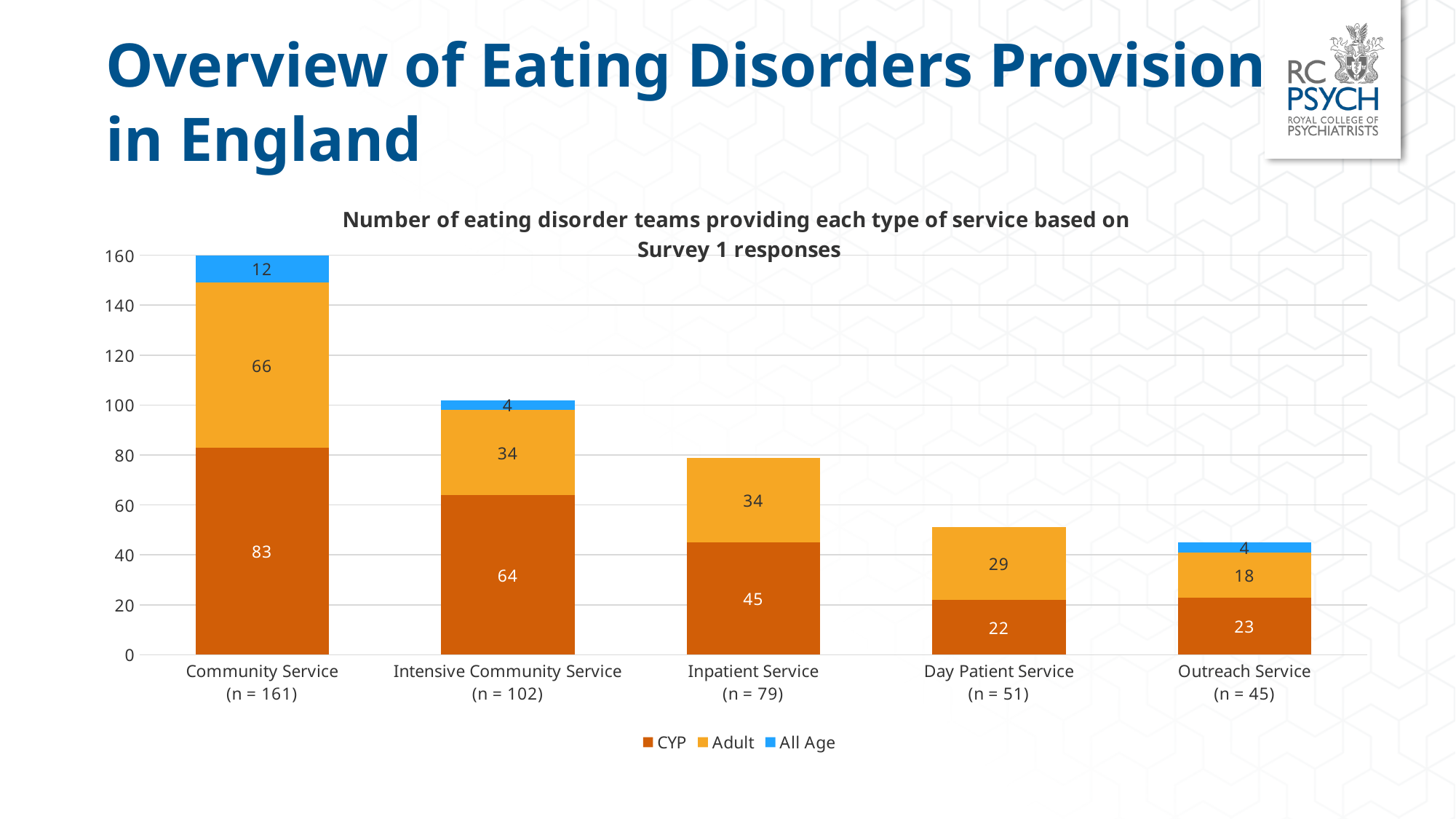
How many series does the legend list? 3 Which service has the lowest Adult value? Outreach Service What is the Adult value for Day Patient Service? 29 Which service has the highest CYP value? Community Service What is the total of the stacked bar for Outreach Service? 45 What is the CYP value for Community Service? 83 Which is larger for Day Patient Service, the CYP value or the Adult value? Adult What is the All Age value for Intensive Community Service? 4 Which series is shown in blue in the legend? All Age How many service categories are shown on the x axis? 5 What is the difference between the CYP values for Community Service and Intensive Community Service? 19 What type of chart is shown on the slide? Stacked bar chart